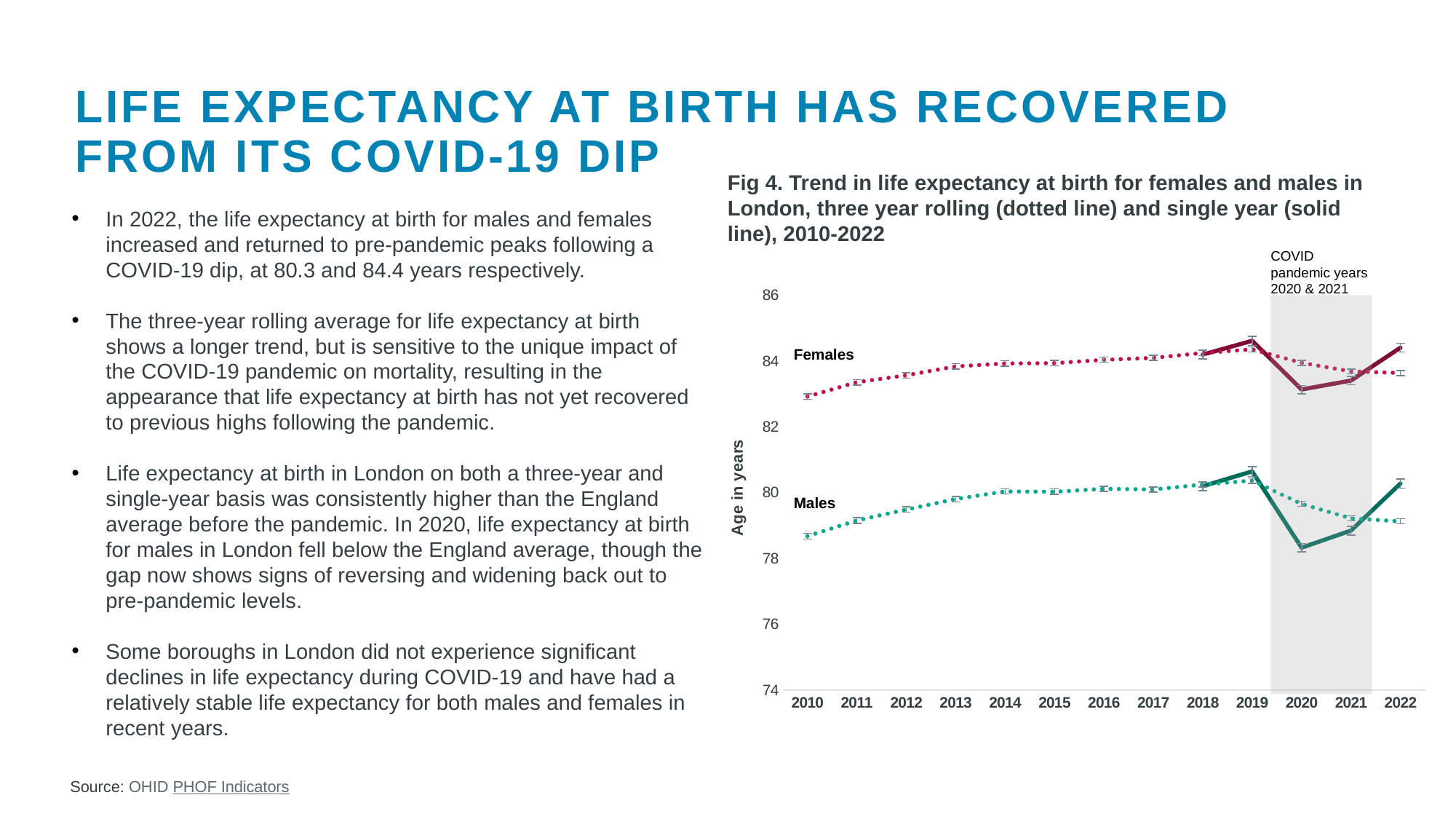
Is the single-year life expectancy value for Males in 2020 greater or less than 80? less Is the single-year life expectancy value for Females in 2020 greater or less than 82? greater In which year is the single-year life expectancy for Males at its lowest? 2020 What kind of chart is Fig 4? Line chart What does the dotted line represent in the chart? Three year rolling life expectancy In 2022, which group has the higher life expectancy at birth, Females or Males? Females Which two groups are plotted in the chart? Females and Males Is the life expectancy value for Males in 2010 greater or less than 80? less How many years are shown on the x axis of the chart? 13 Does the three-year rolling life expectancy for Males rise or fall between 2010 and 2019? Rise